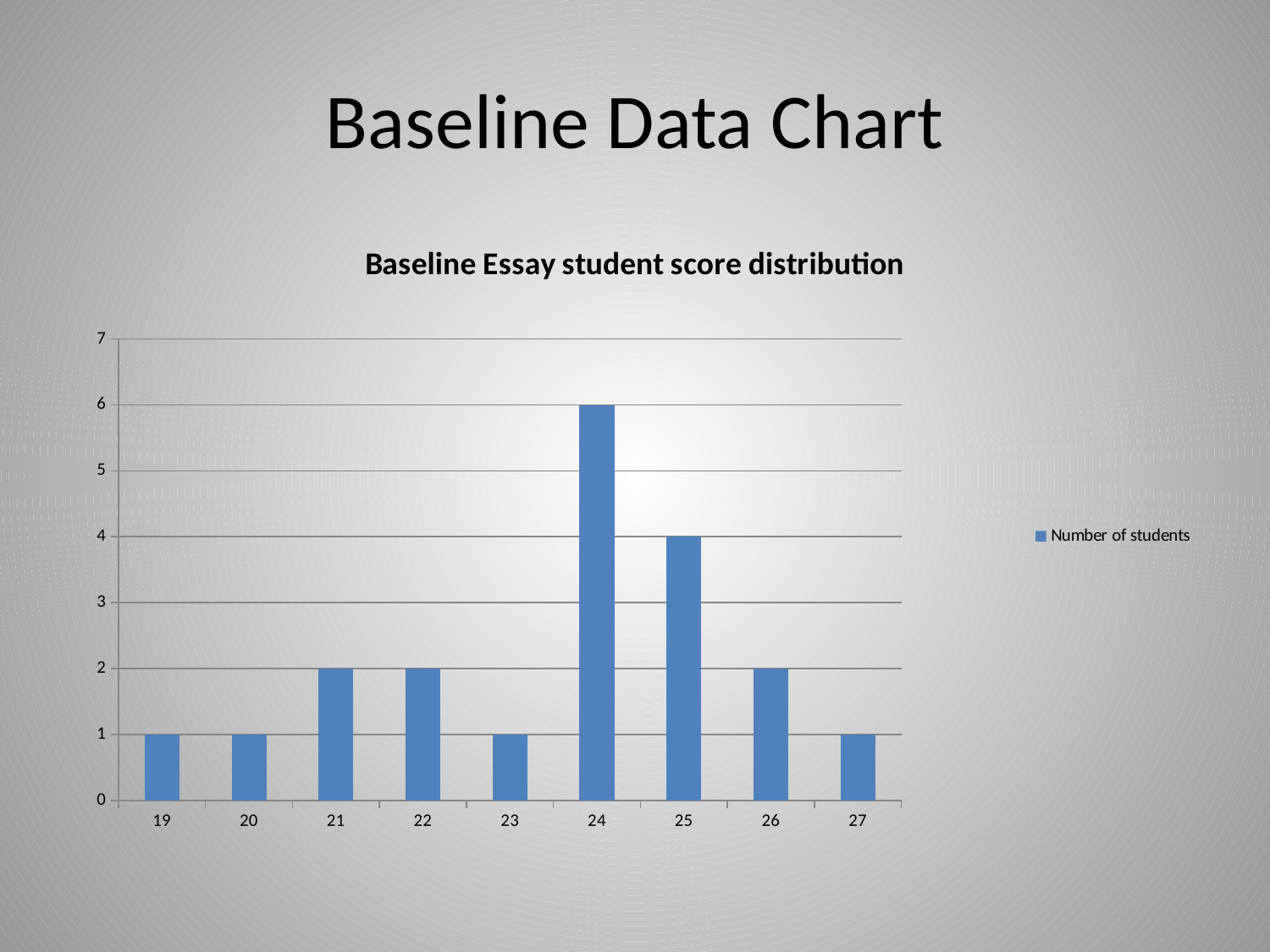
How many score categories are shown on the x axis? 9 How many series does the legend list? 1 Is the number of students with a score of 24 greater or less than 5? greater What is the number of students with a score of 24? 6 Which has more students: a score of 25 or a score of 26? 25 What is the number of students with a score of 21? 2 What is the title of the chart? Baseline Essay student score distribution What is the legend entry for the series? Number of students What kind of chart is shown on the slide? bar chart What is the number of students with a score of 25? 4 Which score has the highest number of students? 24 What is the difference between the number of students scoring 24 and the number scoring 25? 2